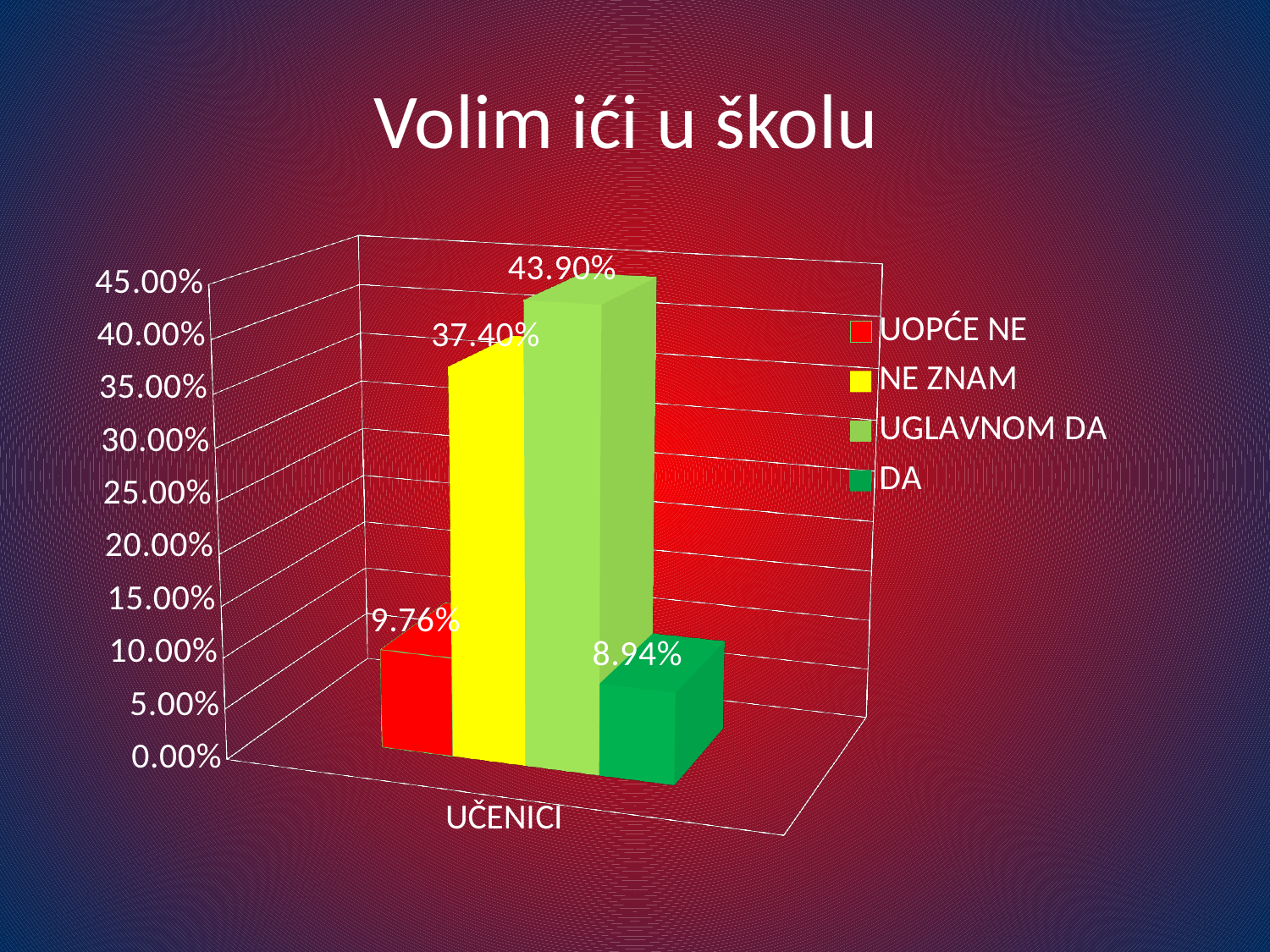
What is the value for NE ZNAM? 37.40% What is the value for UGLAVNOM DA? 43.90% Which is larger, the value for UOPĆE NE or the value for DA? UOPĆE NE What is the title of the chart? Volim ići u školu How many series does the legend list? 4 Which series has the lowest value? DA Is the value for NE ZNAM greater or less than 35.00%? greater Which series has the highest value? UGLAVNOM DA What is the value for UOPĆE NE? 9.76% What is the value for DA? 8.94% What is the difference between the values for UGLAVNOM DA and NE ZNAM? 6.50% What kind of chart is shown on the slide? bar chart